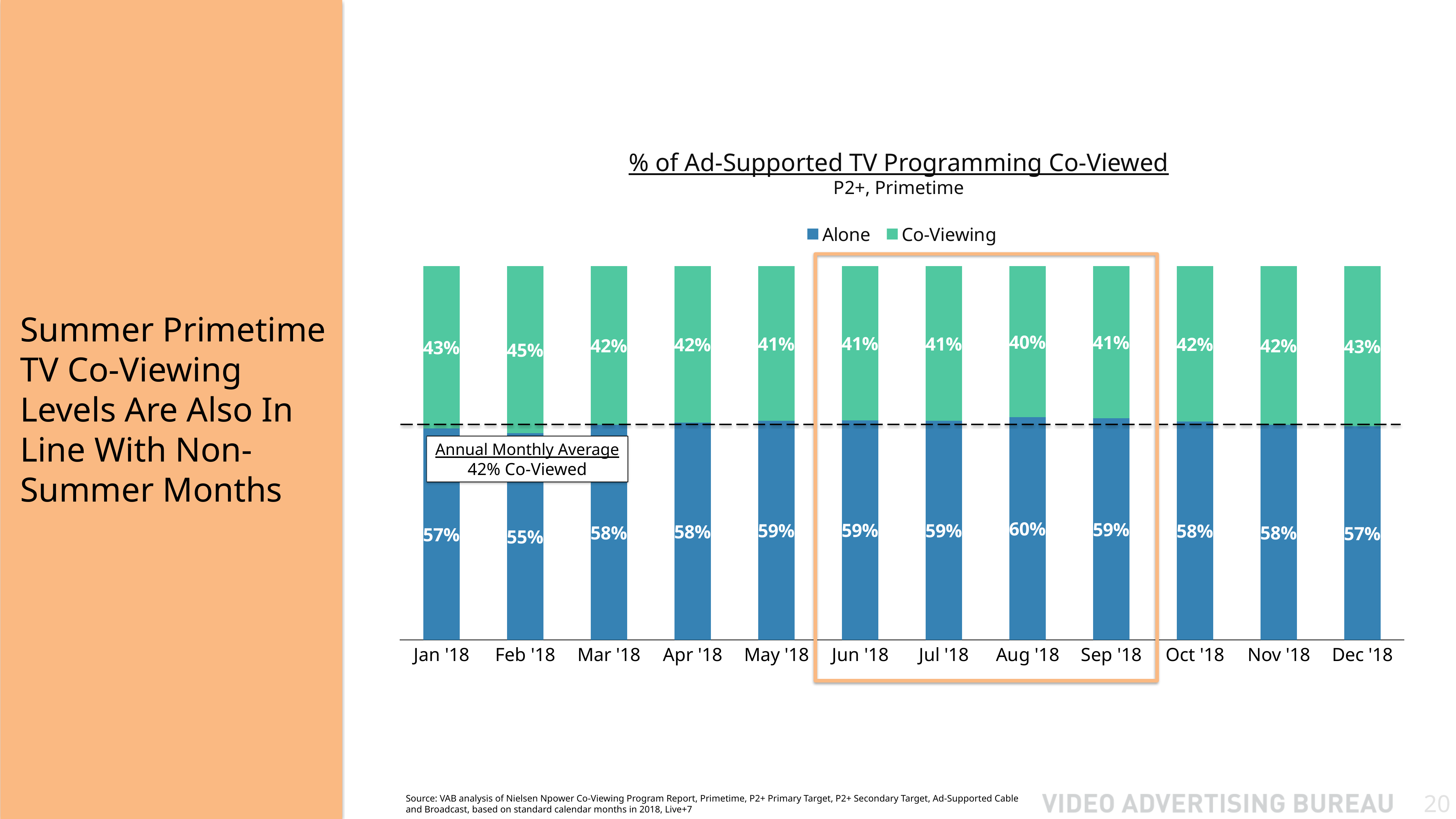
Which month has the lowest Alone value? Feb '18 What is the difference between the Alone value for Aug '18 and the Alone value for Feb '18? 5% Which month has the highest Co-Viewing value? Feb '18 What is the Co-Viewing value for Feb '18? 45% Which is larger, the Co-Viewing value for Jan '18 or the Co-Viewing value for Jul '18? Jan '18 What kind of chart is shown? Stacked bar chart How many months are shown on the x axis? 12 What is the Co-Viewing value for Dec '18? 43% What is the Alone value for Aug '18? 60% Which month has the lowest Co-Viewing value? Aug '18 What annual monthly average co-viewed percentage is marked by the dashed line? 42% How many series does the legend list? 2